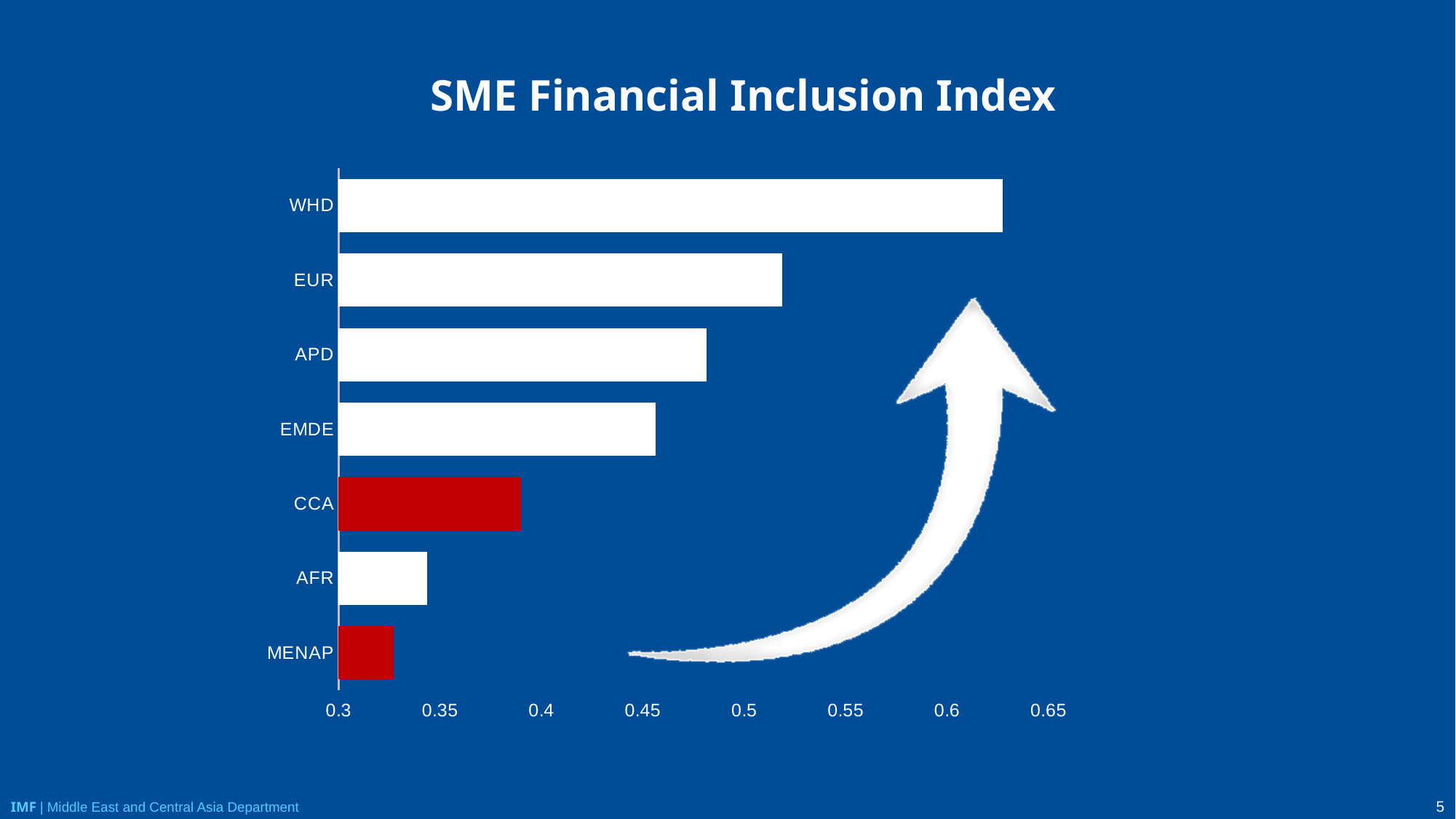
Is the value for EUR greater or less than 0.5? greater Which regions' bars are coloured red in the chart? CCA and MENAP What kind of chart is shown on the slide? Bar chart Which region has the highest SME Financial Inclusion Index? WHD Which has a higher index value, EUR or APD? EUR How many regions are plotted in the chart? 7 Is the value for MENAP greater or less than 0.35? less Is the value for APD greater or less than 0.5? less Which has a higher index value, AFR or MENAP? AFR Which region has the lowest SME Financial Inclusion Index? MENAP What is the title of the chart? SME Financial Inclusion Index